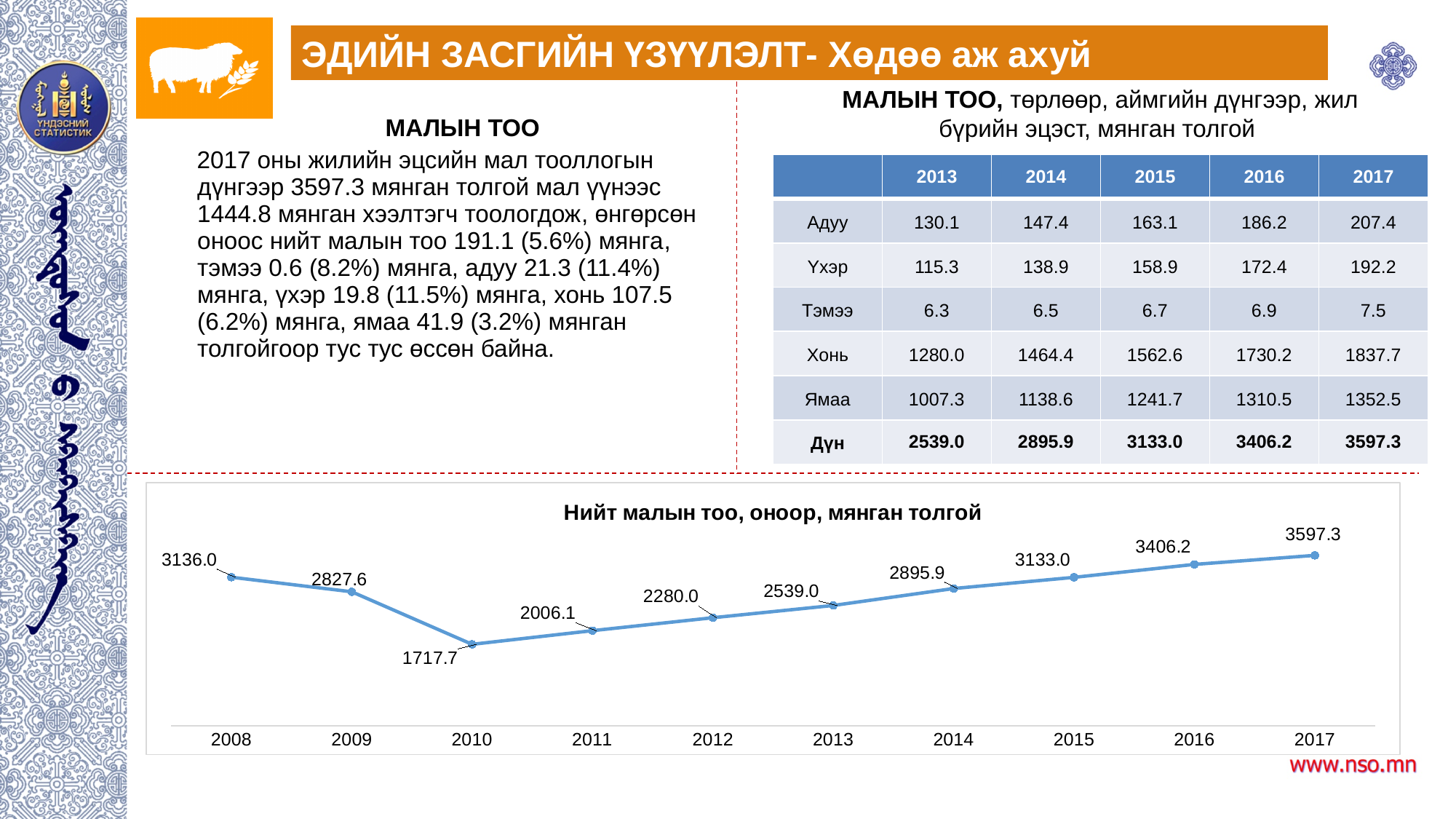
What is the difference between the values for 2008 and 2010 in the chart? 1418.3 Which year has the highest value in the chart? 2017 How many years are plotted in the chart? 10 What is the difference between the values for 2017 and 2016 in the chart? 191.1 What is the title of the chart at the bottom of the slide? Нийт малын тоо, оноор, мянган толгой What is the value for 2008 in the chart? 3136.0 Do the values in the chart rise or fall from 2010 to 2017? rise What type of chart is shown at the bottom of the slide? line chart What is the value for 2010 in the chart? 1717.7 Which is larger in the chart, the value for 2008 or the value for 2015? 2008 Which year has the lowest value in the chart? 2010 What is the value for 2017 in the chart? 3597.3